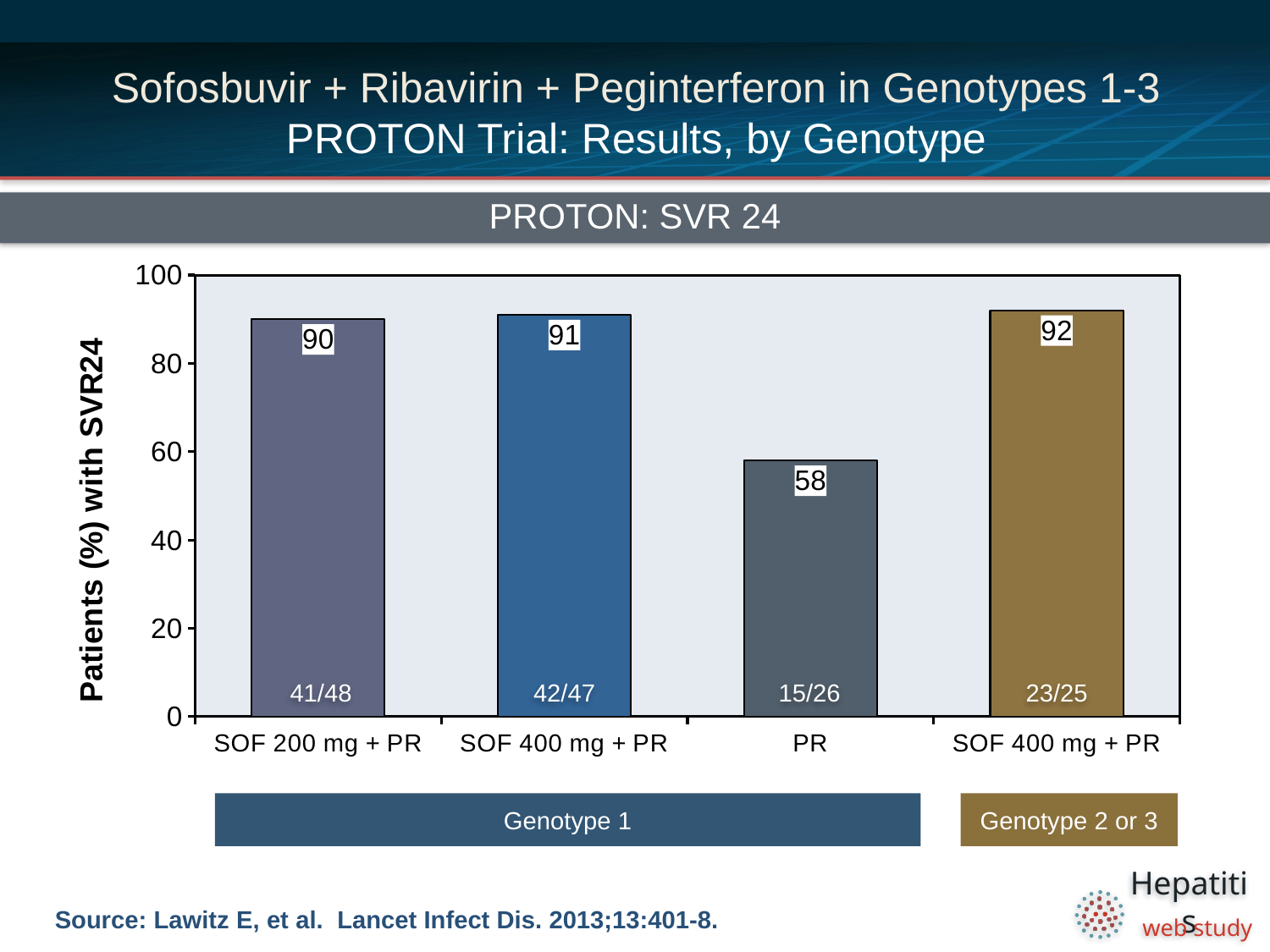
What fraction of patients is shown inside the PR bar? 15/26 Which arm has the lowest SVR24 rate? PR What is the SVR24 rate for SOF 400 mg + PR in Genotype 2 or 3? 92 What fraction of patients is shown inside the SOF 400 mg + PR bar for Genotype 1? 42/47 What type of chart is shown on the slide? Bar chart What is the label of the y-axis? Patients (%) with SVR24 Which arm has the highest SVR24 rate? SOF 400 mg + PR (Genotype 2 or 3) What is the difference in SVR24 rate between SOF 400 mg + PR in Genotype 1 and PR? 33 What is the SVR24 rate for SOF 200 mg + PR in Genotype 1? 90 Which has a higher SVR24 rate, SOF 200 mg + PR or PR? SOF 200 mg + PR What is the SVR24 rate for the PR arm? 58 How many bars are shown in the chart? 4